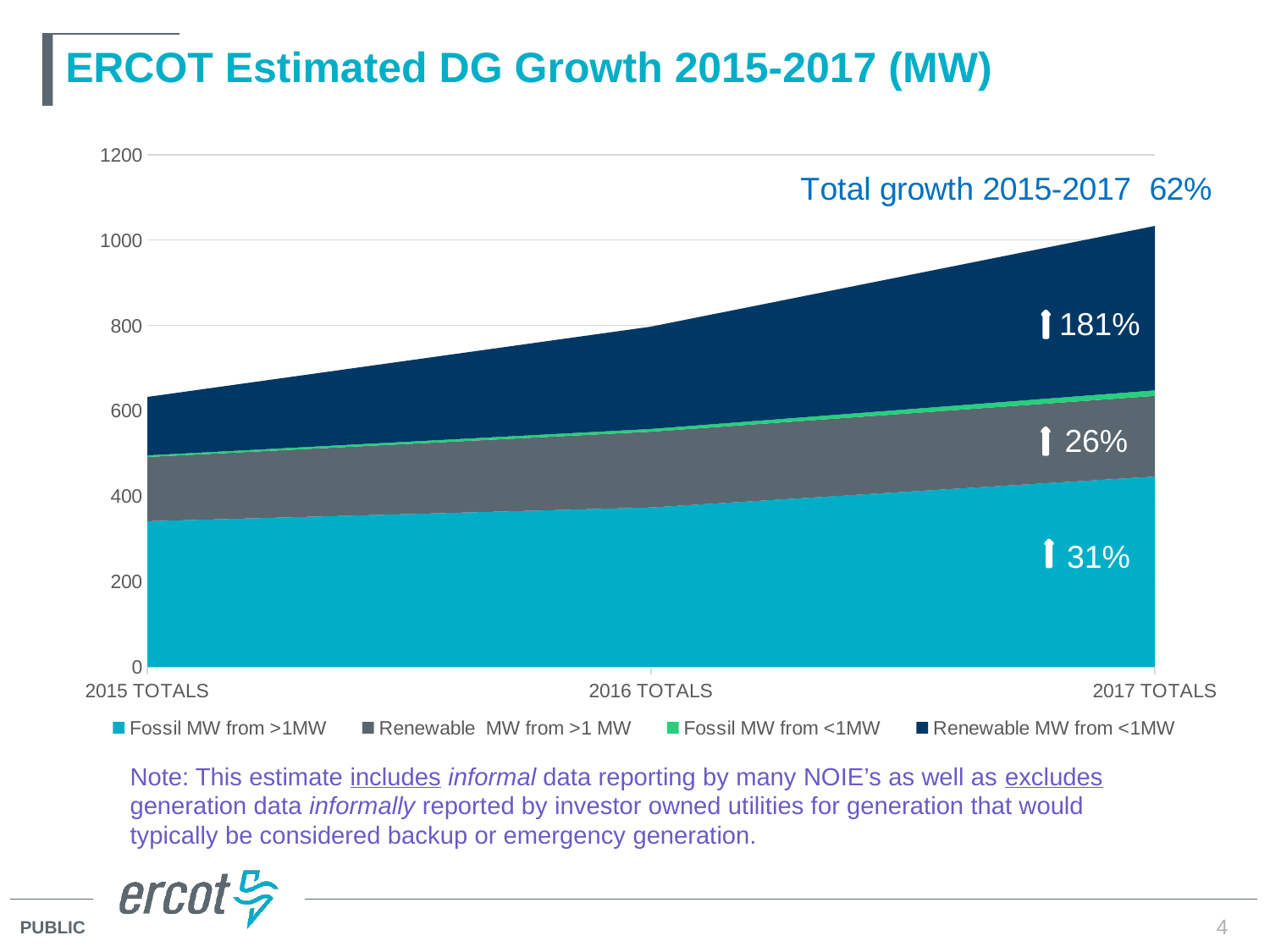
What growth percentage is labelled on the Renewable MW from <1MW area? 181% What kind of chart is shown on the slide? Stacked area chart How many series does the legend list? 4 Is the total stacked value for 2017 TOTALS greater or less than 1000? greater Which series shows the highest labelled growth percentage? Renewable MW from <1MW What is the title of the chart? ERCOT Estimated DG Growth 2015-2017 (MW) How many categories are shown on the x axis? 3 What growth percentage is labelled on the Renewable MW from >1 MW area? 26% Does the total stacked value rise or fall from 2015 TOTALS to 2017 TOTALS? rise What total growth from 2015 to 2017 is stated on the chart? 62% What growth percentage is labelled on the Fossil MW from >1MW area? 31% Is the Fossil MW from >1MW value for 2015 TOTALS greater or less than 400? less